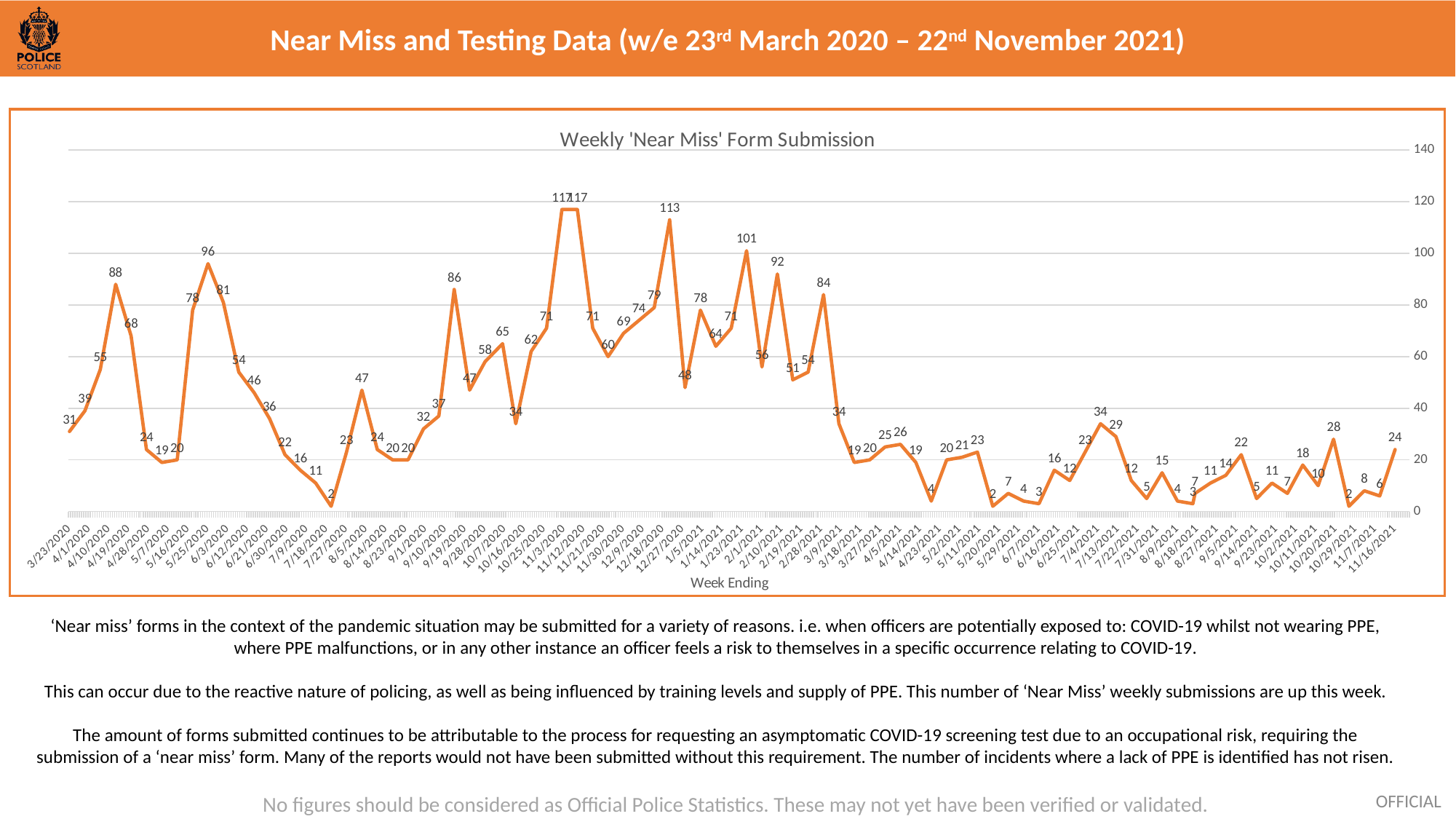
What is the lowest weekly value plotted on the chart? 2 What is the title of the chart? Weekly 'Near Miss' Form Submission Is the value for the last week shown (11/16/2021) greater or less than 40? less What is the difference between the value for week ending 3/23/2020 and the value for week ending 11/16/2021? 7 What is the value for the last week shown, week ending 11/16/2021? 24 What type of chart is shown on the slide? line chart What is the value for the first week shown, week ending 3/23/2020? 31 What is the title of the x axis? Week Ending Which is larger, the value for week ending 3/23/2020 or the value for week ending 11/16/2021? 3/23/2020 What is the maximum value shown on the vertical axis? 140 What is the highest weekly value plotted on the chart? 117 What is the difference between the highest value (117) and the lowest value (2) on the chart? 115